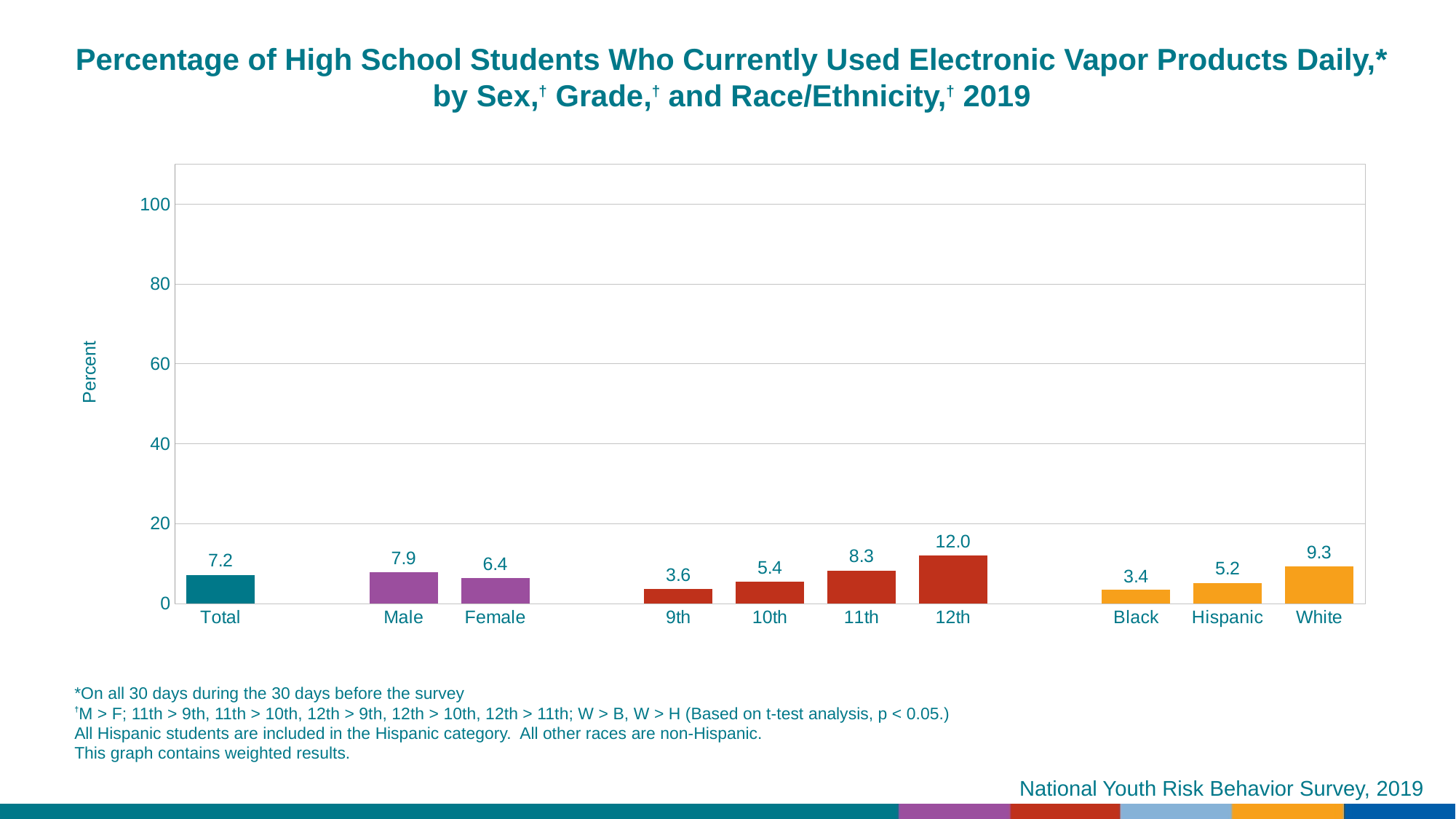
Which category has the highest value? 12th What kind of chart is this? bar chart What is the value for Total? 7.2 What is the difference between the values for Male and Female? 1.5 How many categories are shown on the x axis? 10 Do the values rise or fall from 9th grade to 12th grade? rise What is the value for 12th grade students? 12.0 Is the value for 12th grade greater or less than 20? less What is the value for Hispanic students? 5.2 What is the label on the y axis? Percent Which is larger, the value for White or the value for Hispanic? White Which category has the lowest value? Black